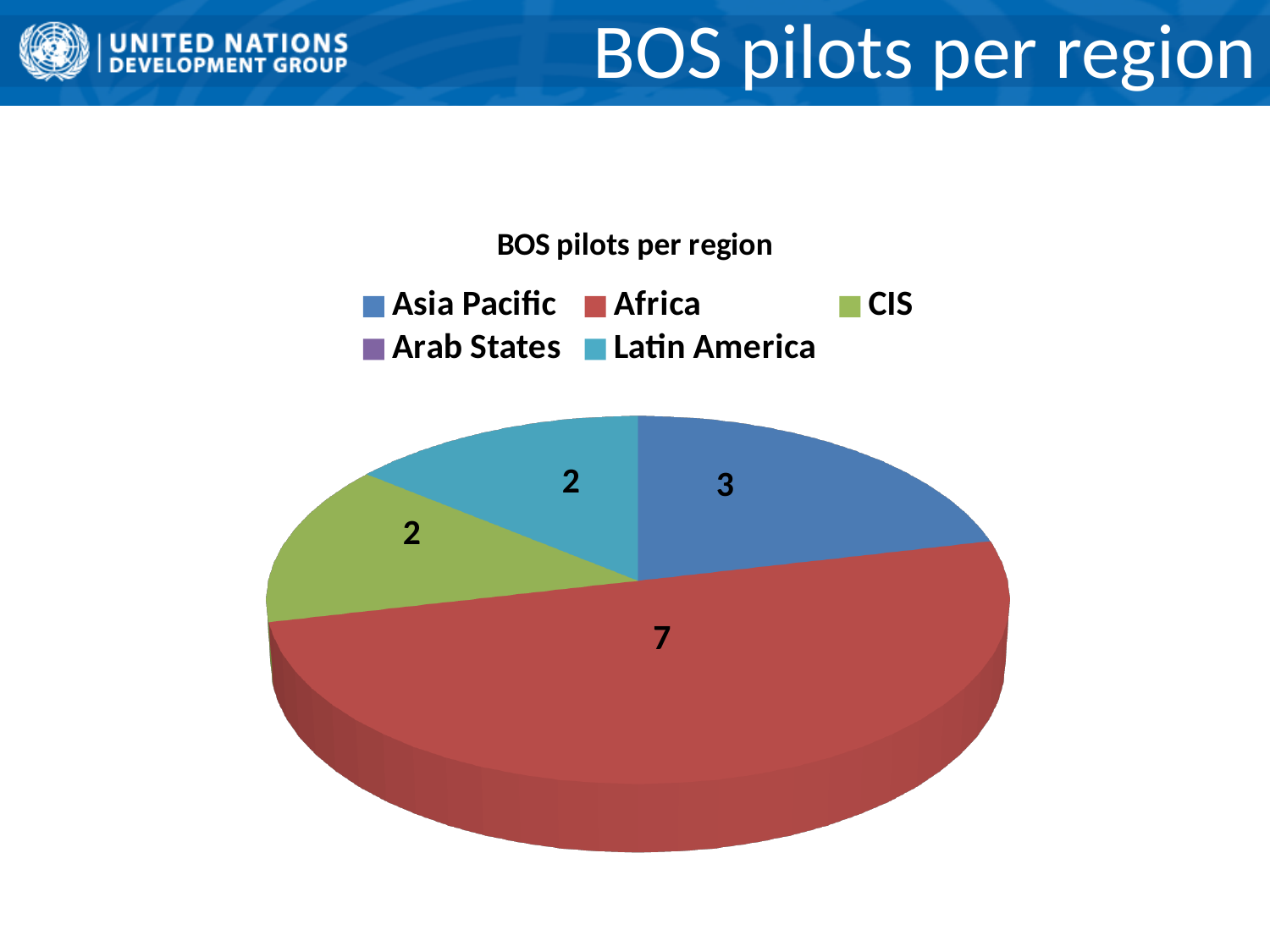
What kind of chart is shown on the slide? pie chart How many BOS pilots are in CIS? 2 How many BOS pilots are in Africa? 7 What is the title of the chart? BOS pilots per region How many slices with data labels are shown in the pie chart? 4 How many BOS pilots are in Asia Pacific? 3 Which region has the most BOS pilots? Africa How many more BOS pilots does Africa have than Asia Pacific? 4 Which has more BOS pilots, Asia Pacific or CIS? Asia Pacific How many BOS pilots are in Latin America? 2 How many regions are listed in the chart legend? 5 How many more BOS pilots does Asia Pacific have than Latin America? 1